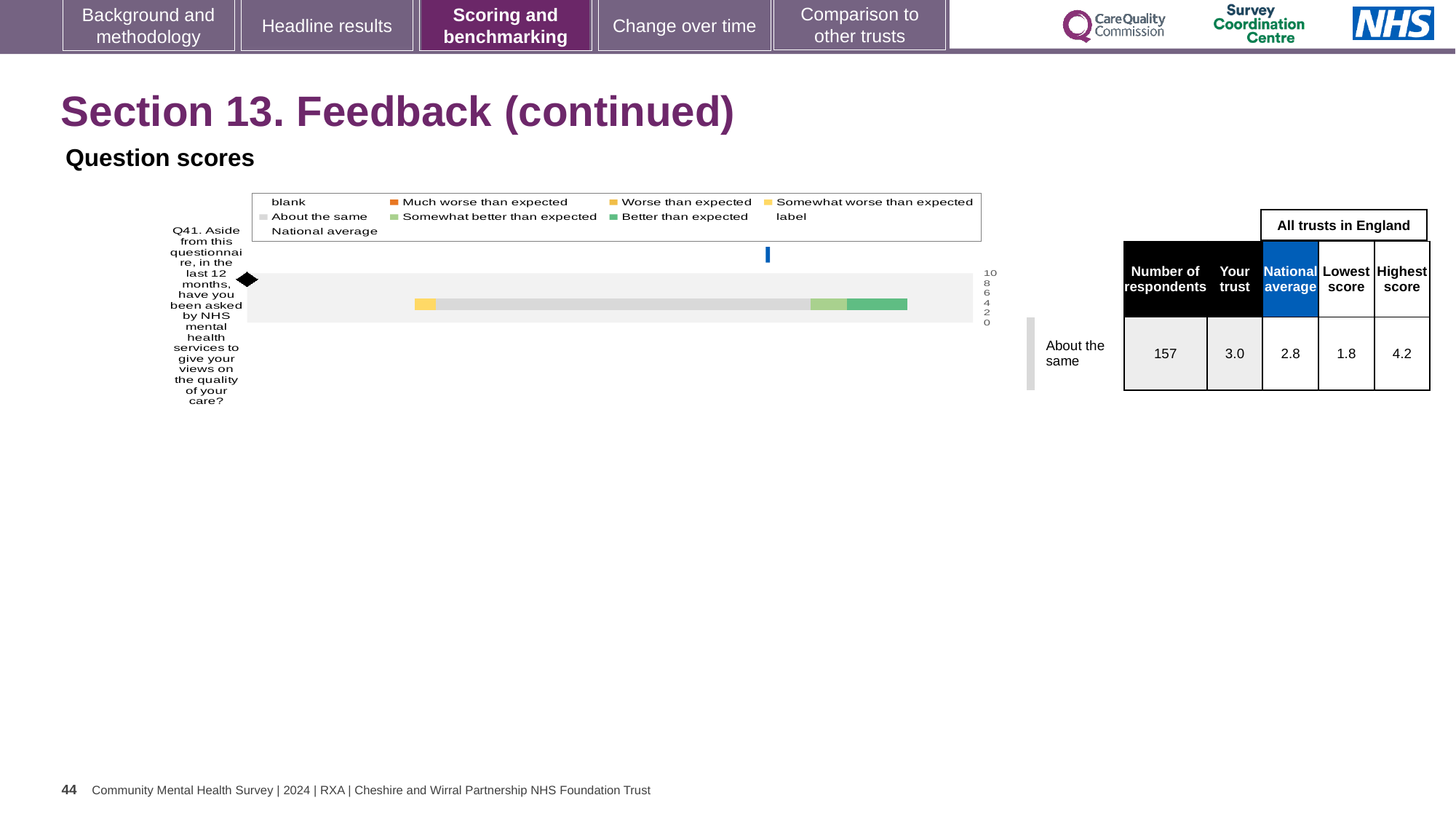
How many questions are plotted in the chart? 1 What is the lowest score among all trusts in England for Q41? 1.8 By how much does the 'Your trust' score exceed the national average for Q41? 0.2 What is the highest score among all trusts in England for Q41? 4.2 What kind of chart is shown on the slide? bar chart Which is larger for Q41, the 'Your trust' score or the national average? Your trust What benchmark category is shown for Q41 next to the chart? About the same What is the national average score for Q41? 2.8 What is the 'Your trust' score for Q41? 3.0 Which question number is plotted in the chart? Q41 How many respondents answered Q41? 157 What is the difference between the highest score and the lowest score for Q41? 2.4